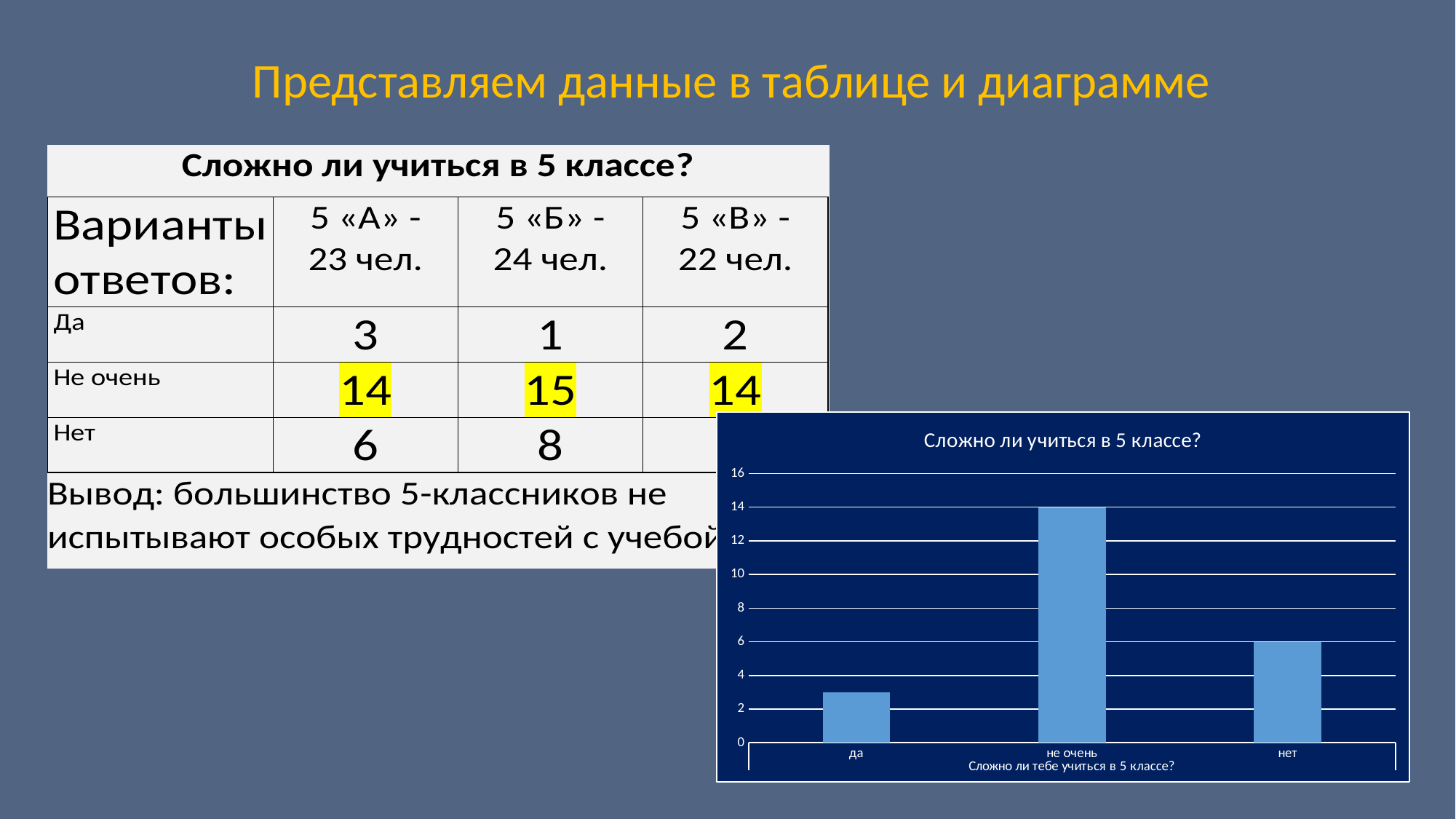
What kind of chart is shown on the slide? bar chart Is the value for "не очень" greater or less than 10? greater What is the value of the bar for "нет" in the chart? 6 Is the value for "да" greater or less than 2? greater What is the difference between the values for "не очень" and "нет" in the chart? 8 How many categories are shown on the x axis of the chart? 3 Which category has the lowest bar in the chart? да What is the title of the chart? Сложно ли учиться в 5 классе? Which category has the highest bar in the chart? не очень What is the value of the bar for "не очень" in the chart? 14 Which bar is taller in the chart, "нет" or "да"? нет Is the value for "да" greater or less than 4? less